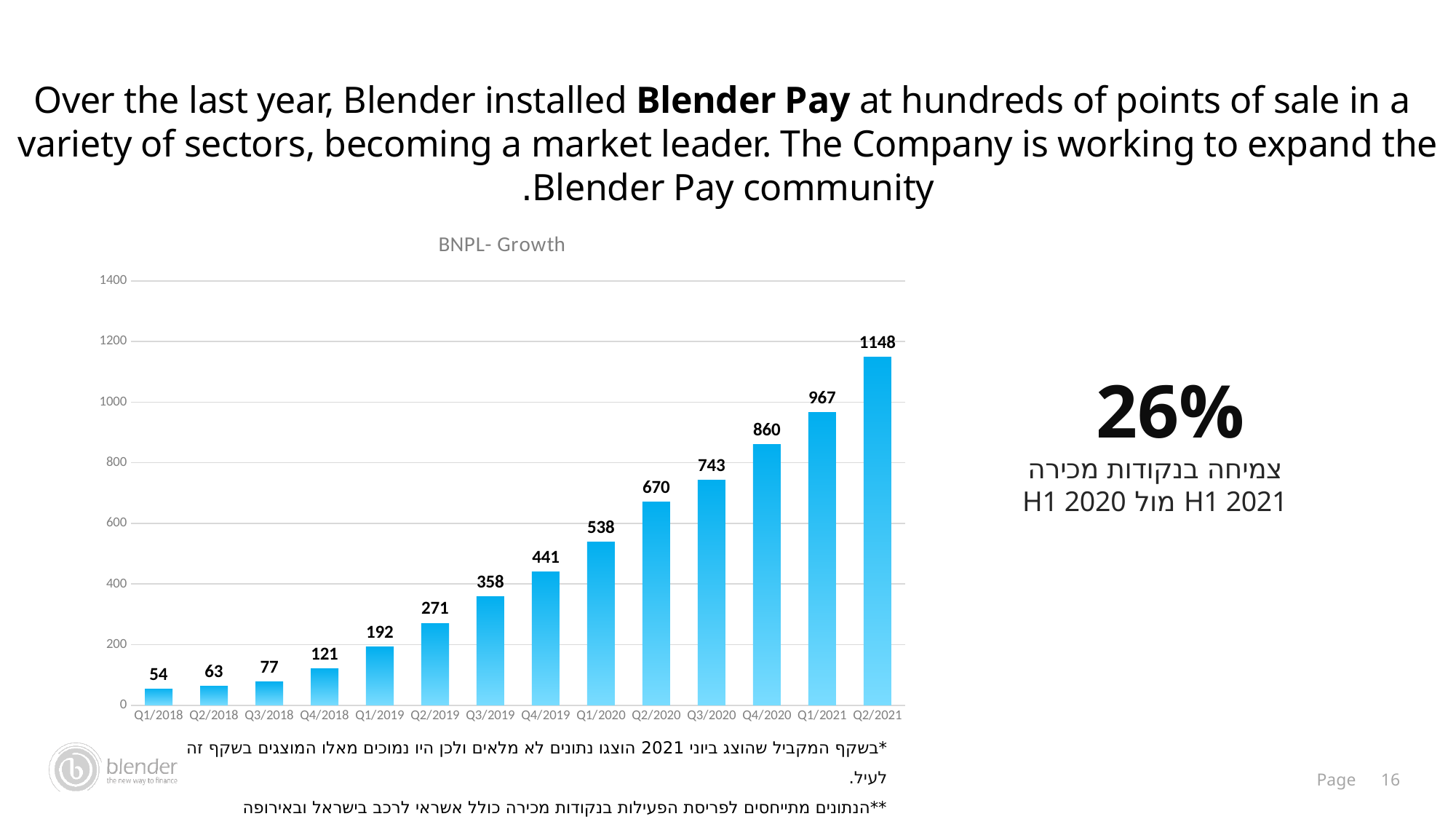
What kind of chart is the BNPL- Growth chart? Bar chart What is the value for Q1/2018 in the BNPL- Growth chart? 54 Which quarter has the highest value in the BNPL- Growth chart? Q2/2021 What is the value for Q4/2020 in the BNPL- Growth chart? 860 What is the difference between the values for Q1/2020 and Q1/2019? 346 Which quarter has the lowest value in the BNPL- Growth chart? Q1/2018 How many quarters are shown in the BNPL- Growth chart? 14 What is the value for Q2/2021 in the BNPL- Growth chart? 1148 Do the values in the BNPL- Growth chart rise or fall from Q1/2018 to Q2/2021? Rise Which is larger, the value for Q3/2020 or the value for Q2/2020? Q3/2020 What is the value for Q3/2019 in the BNPL- Growth chart? 358 What is the difference between the values for Q2/2021 and Q1/2021? 181